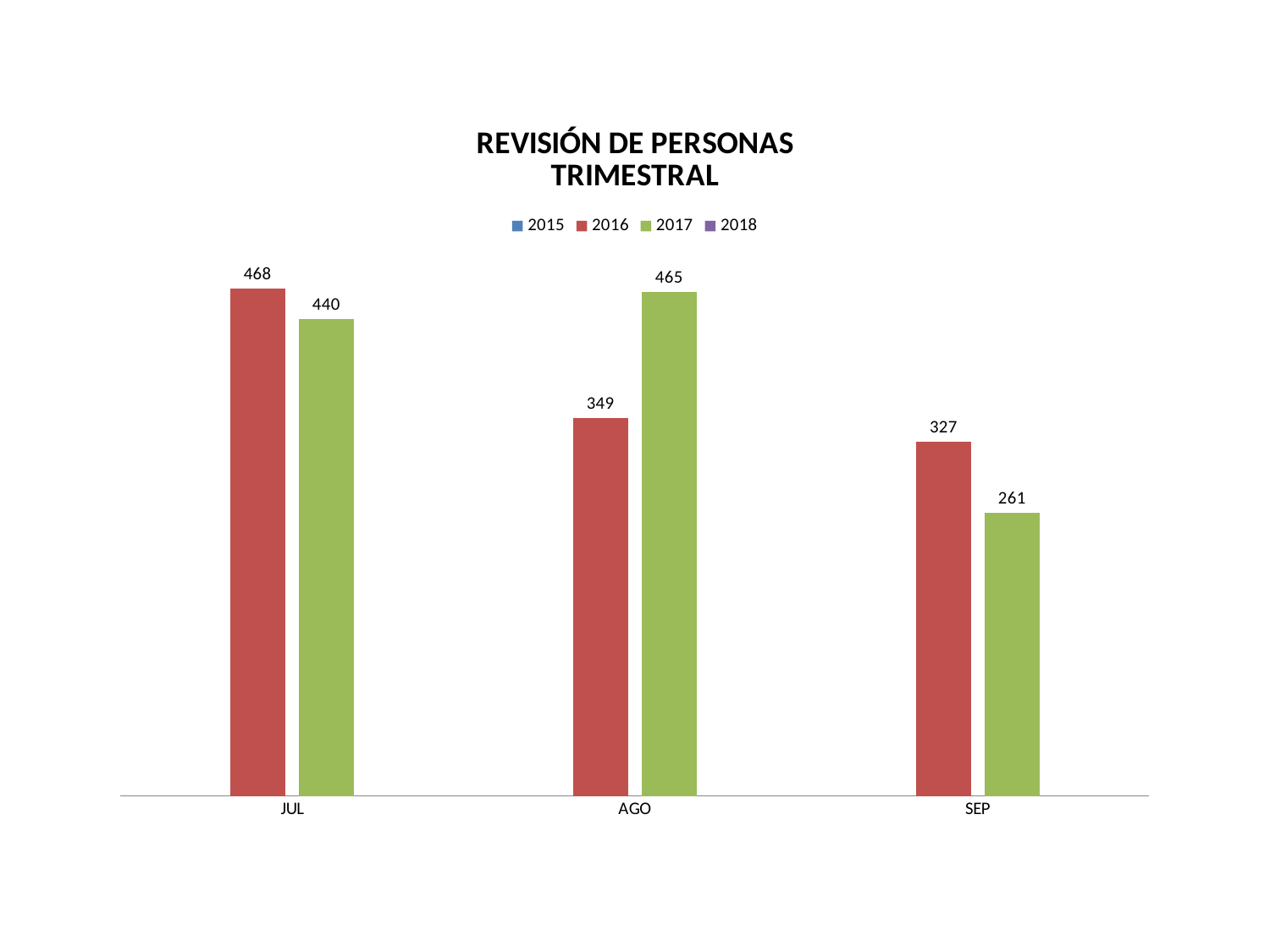
What is the difference between the 2017 and 2016 values in AGO? 116 How many series does the legend list? 4 What is the value for 2017 in AGO? 465 In which month is the 2016 value highest? JUL What kind of chart is shown? Bar chart What is the title of the chart? REVISIÓN DE PERSONAS TRIMESTRAL In which month is the 2017 value lowest? SEP What is the value for 2016 in JUL? 468 What is the value for 2017 in SEP? 261 How many months are shown on the x axis? 3 Which is larger in JUL, the 2016 value or the 2017 value? 2016 What is the value for 2016 in AGO? 349